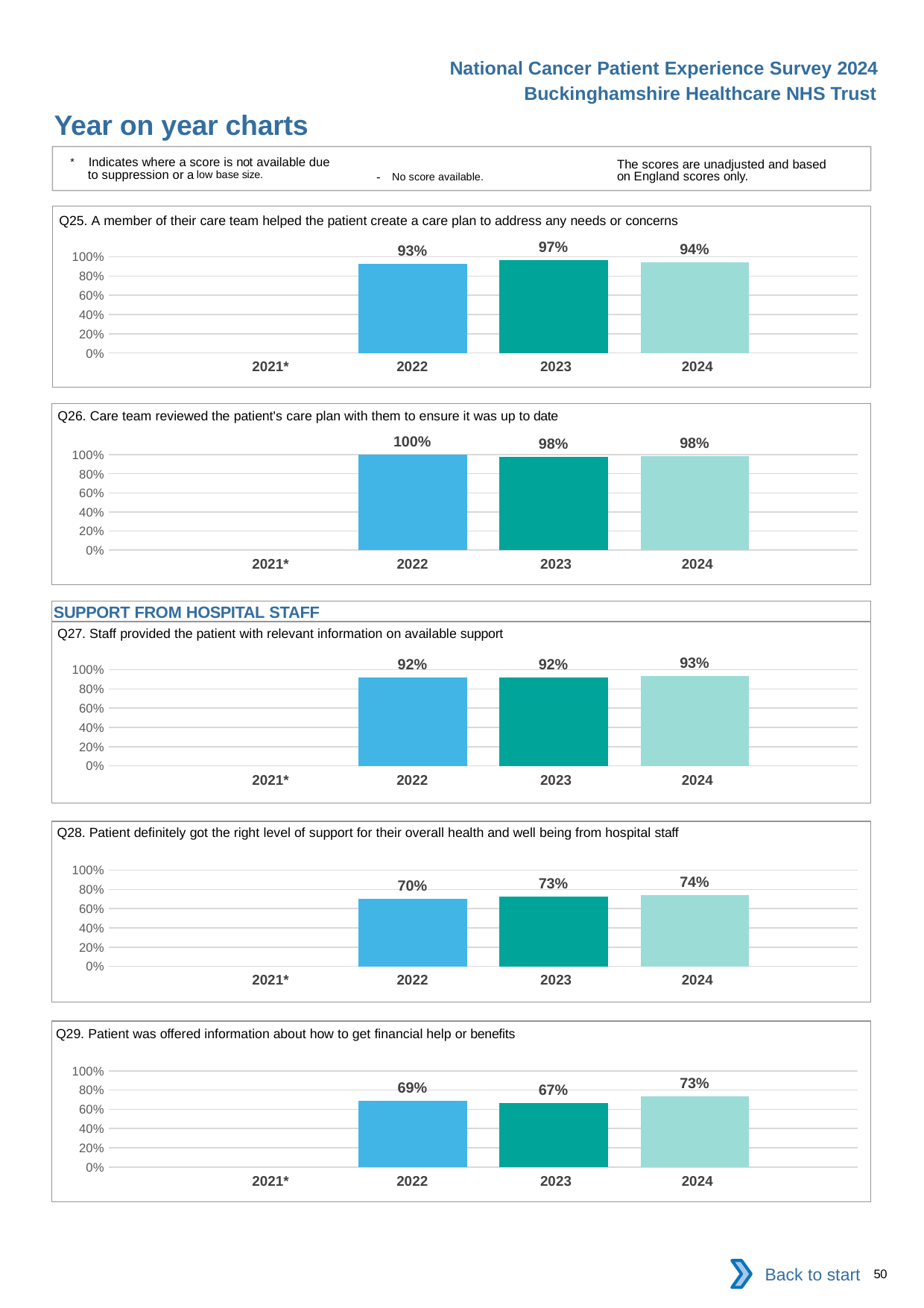
Which year on the x axis of the Q26 chart is marked with an asterisk? 2021* In the Q28 chart, is the value for 2023 greater or less than 80%? less In the Q25 chart, what is the difference between the 2023 and 2022 values? 4% In the Q28 chart, do the values rise or fall from 2022 to 2024? rise In the Q25 chart, what is the value for 2023? 97% In the Q26 chart, what is the value for 2022? 100% In the Q29 chart, which year has the lowest value? 2023 In the Q28 chart, what is the difference between the 2024 and 2022 values? 4% In the Q29 chart, is the value for 2024 larger or smaller than the value for 2022? larger How many year categories are shown on the x axis of the Q25 chart? 4 What kind of chart is the Q27 chart? bar chart In the Q27 chart, which year has the highest value? 2024